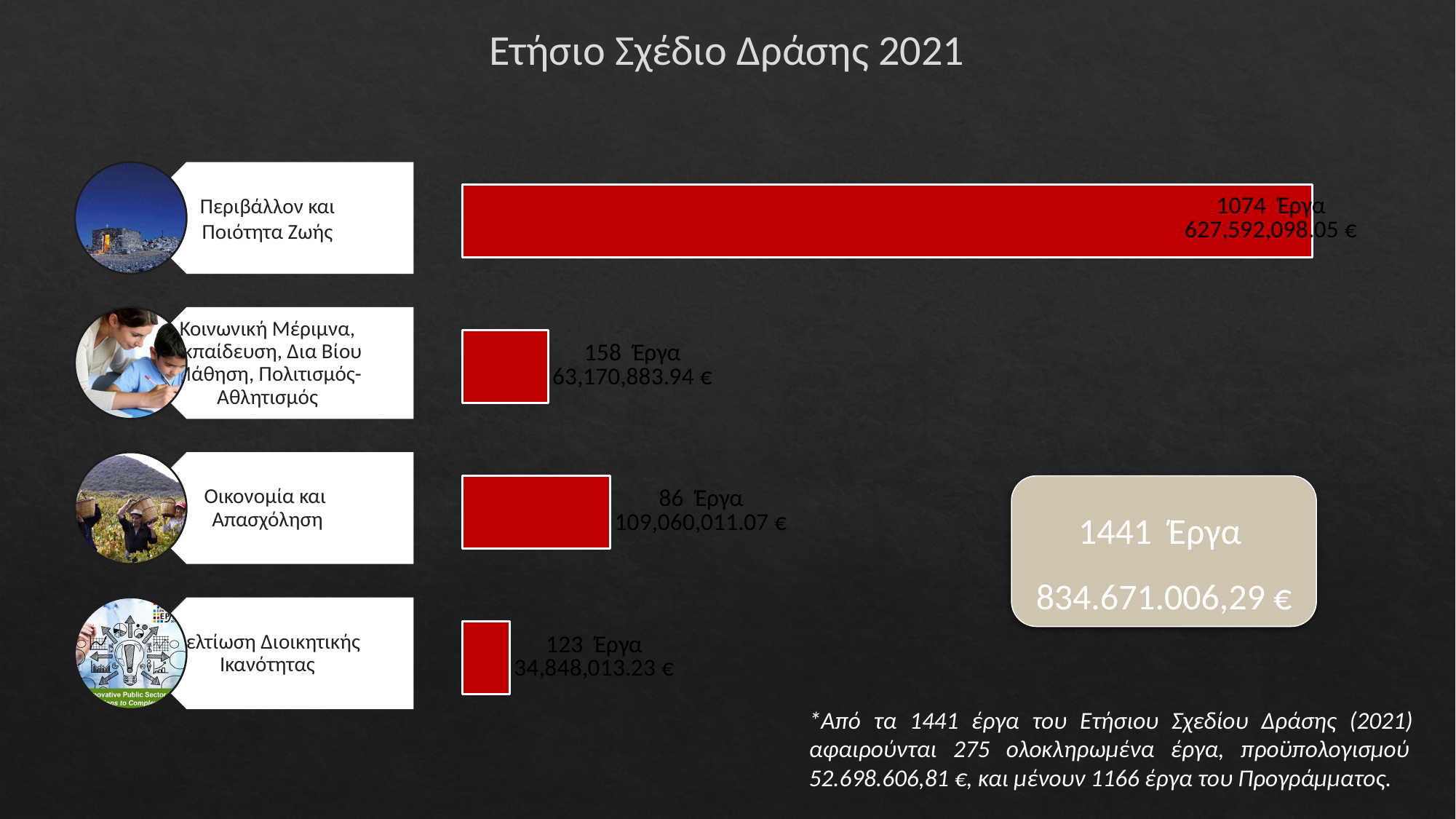
What kind of chart is shown on the slide? bar chart What is the difference in number of projects between Περιβάλλον και Ποιότητα Ζωής and Οικονομία και Απασχόληση? 988 Which category has the shortest bar? Βελτίωση Διοικητικής Ικανότητας What total number of projects is shown in the summary box on the slide? 1441 Έργα What budget amount is shown for Βελτίωση Διοικητικής Ικανότητας? 34,848,013.23 € How many projects (Έργα) are shown for Βελτίωση Διοικητικής Ικανότητας? 123 Έργα Which category has the longest bar? Περιβάλλον και Ποιότητα Ζωής What budget amount is shown for Οικονομία και Απασχόληση? 109,060,011.07 € What budget amount is shown for Περιβάλλον και Ποιότητα Ζωής? 627,592,098.05 € How many categories does the bar chart show? 4 How many projects (Έργα) are shown for Περιβάλλον και Ποιότητα Ζωής? 1074 Έργα Which has more projects: Οικονομία και Απασχόληση or Βελτίωση Διοικητικής Ικανότητας? Βελτίωση Διοικητικής Ικανότητας